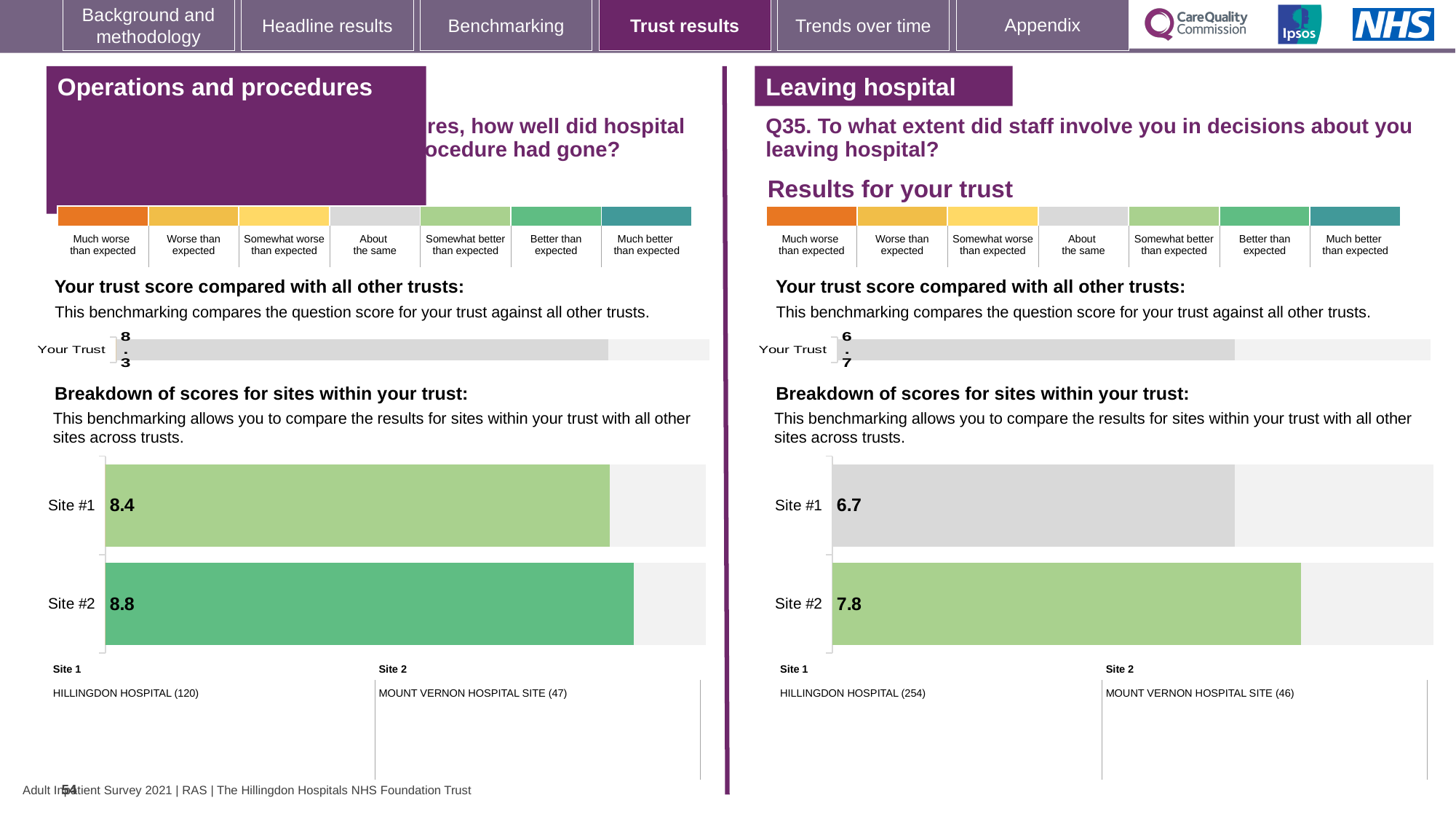
In the site breakdown chart under 'Operations and procedures' (left side), which site has the higher score? Site #2 What type of chart is used for the site breakdown under 'Operations and procedures' (left side)? Bar chart How many sites are shown in the site breakdown chart for Q35 'Leaving hospital' (right side)? 2 In the site breakdown chart for Q35 'Leaving hospital' (right side), what is the difference between the Site #2 and Site #1 scores? 1.1 In the 'Breakdown of scores for sites within your trust' chart under 'Operations and procedures' (left side), what is the score for Site #2? 8.8 In the 'Breakdown of scores for sites within your trust' chart under 'Operations and procedures' (left side), what is the score for Site #1? 8.4 In the site breakdown chart for Q35 'Leaving hospital' (right side), which site has the lower score? Site #1 In the 'Your trust score compared with all other trusts' chart for Q35 'Leaving hospital' (right side), what is the score for Your Trust? 6.7 In the 'Your trust score compared with all other trusts' chart under 'Operations and procedures' (left side), what is the score for Your Trust? 8.3 In the 'Breakdown of scores for sites within your trust' chart for Q35 'Leaving hospital' (right side), what is the score for Site #2? 7.8 In the 'Breakdown of scores for sites within your trust' chart for Q35 'Leaving hospital' (right side), what is the score for Site #1? 6.7 In the site breakdown chart under 'Operations and procedures' (left side), what is the difference between the Site #2 and Site #1 scores? 0.4